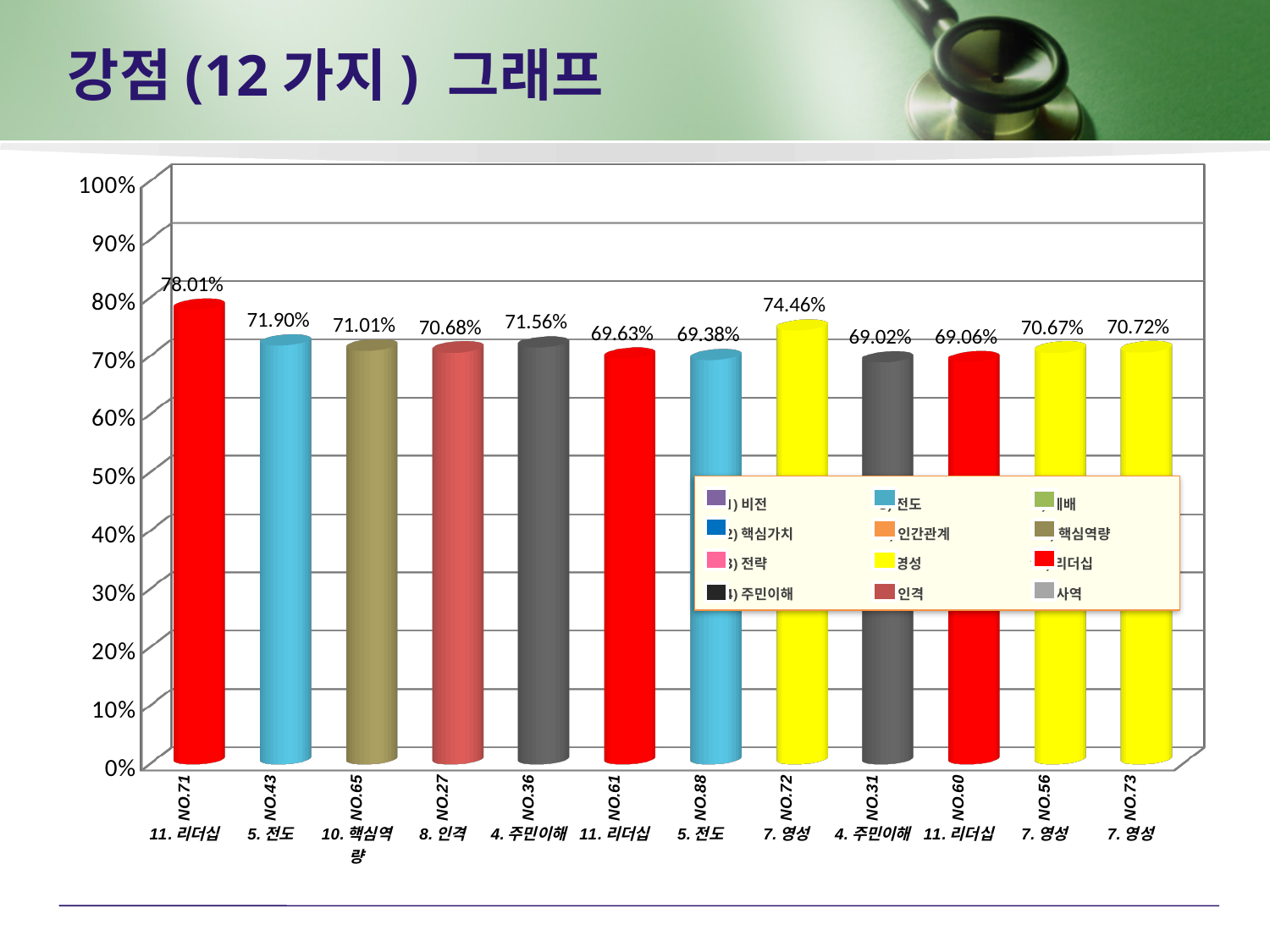
What kind of chart is shown on the slide? bar chart What is the value for NO.71? 78.01% What is the value for NO.72? 74.46% Which category has the lowest value? NO.31 What is the value for NO.31? 69.02% What is the value for NO.56? 70.67% Is the value for NO.61 greater or less than 70%? less Which is larger, the value for NO.43 or the value for NO.88? NO.43 What is the title of the slide? 강점 (12 가지 ) 그래프 How many bars are plotted in the chart? 12 What is the difference between the values for NO.71 and NO.72? 3.55% Which category has the highest value? NO.71